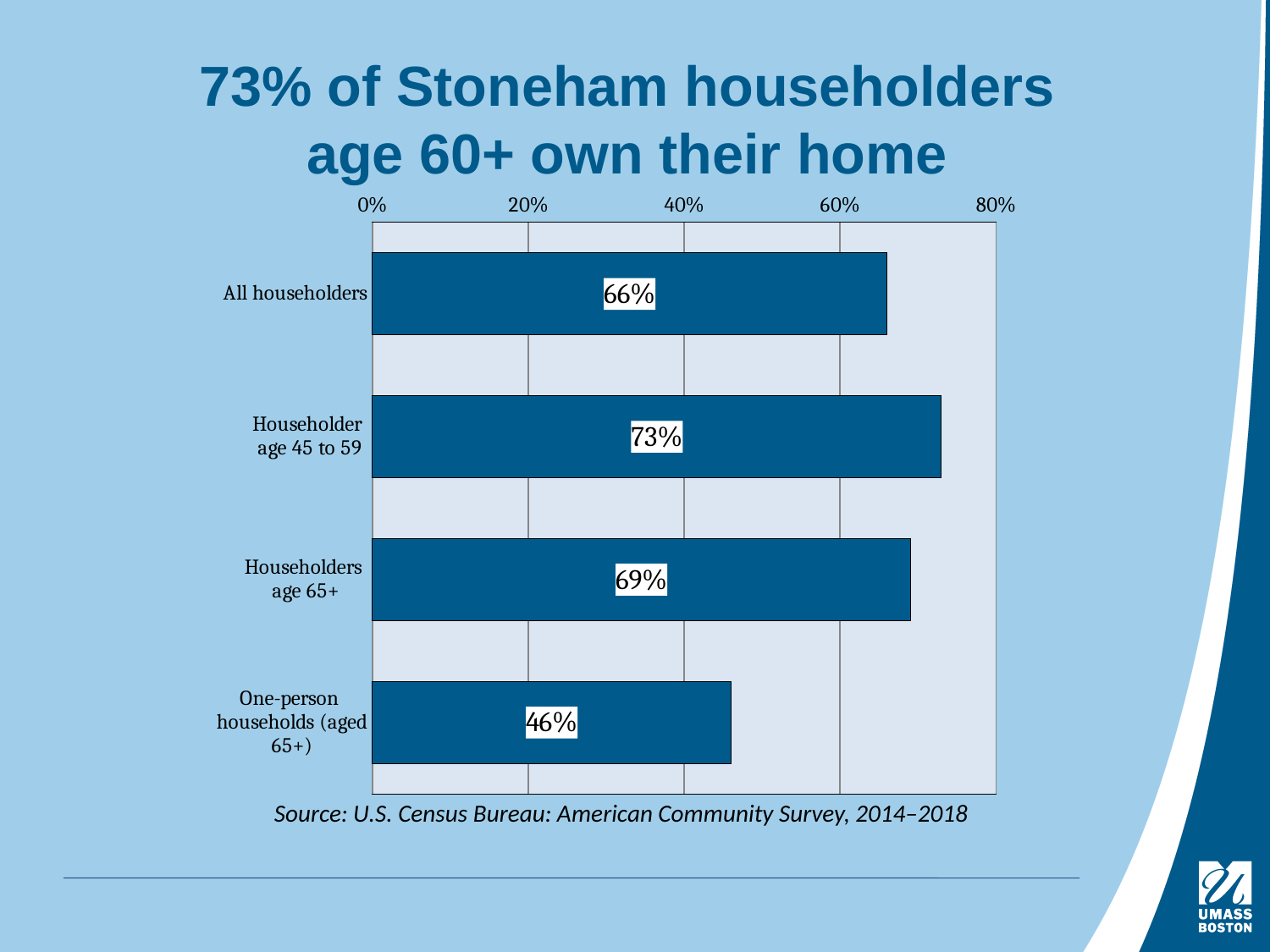
What is the value for All householders? 66% What is the value for Householders age 65+? 69% Which category has the lowest value? One-person households (aged 65+) What kind of chart is shown on the slide? Bar chart How many categories are shown in the chart? 4 What is the value for Householder age 45 to 59? 73% What is the difference between the values for Householders age 65+ and One-person households (aged 65+)? 23% What is the difference between the values for Householder age 45 to 59 and All householders? 7% Which is larger, the value for Householders age 65+ or the value for All householders? Householders age 65+ Which category has the highest value? Householder age 45 to 59 What is the value for One-person households (aged 65+)? 46% What is the title of the slide? 73% of Stoneham householders age 60+ own their home